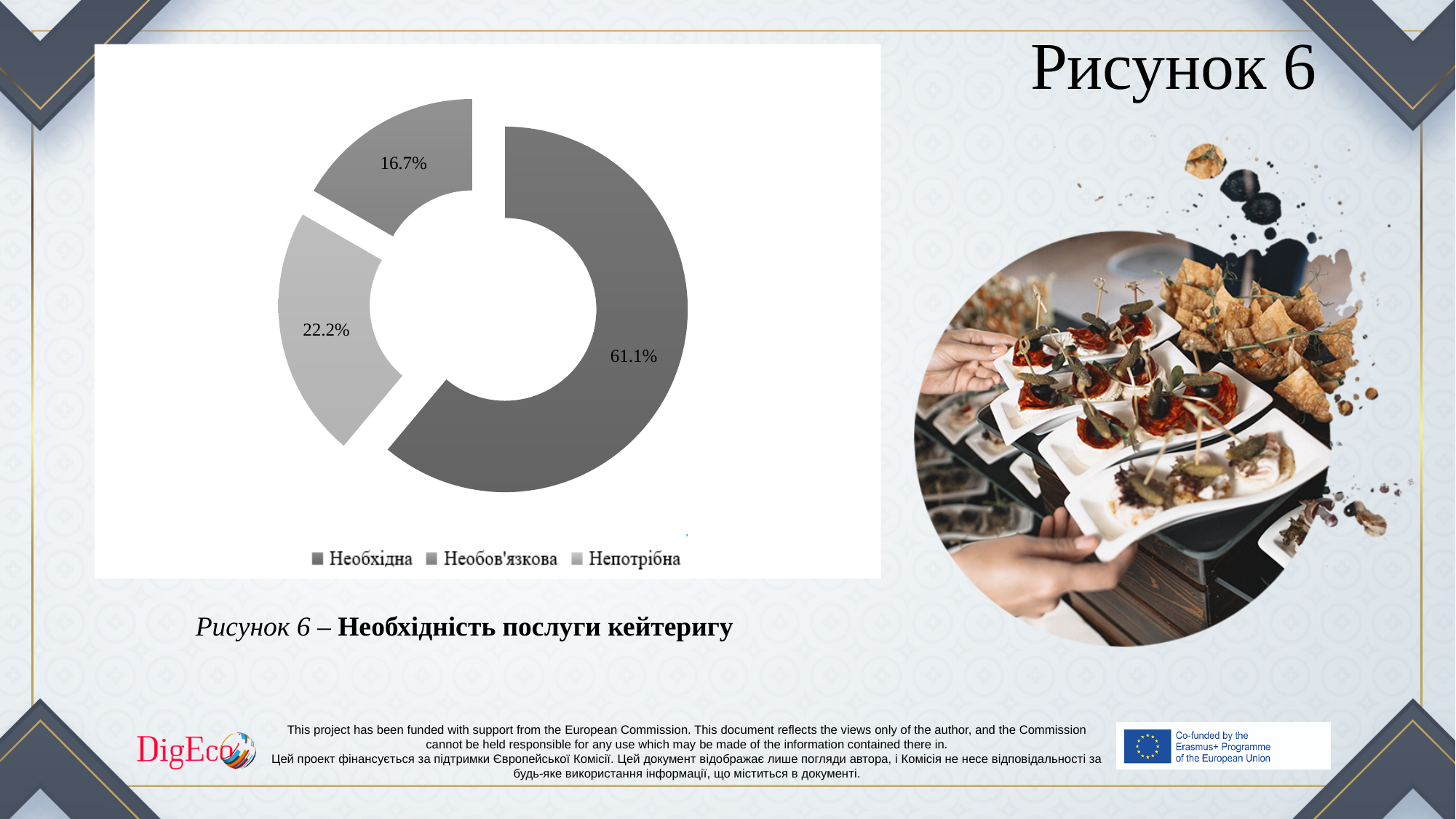
Which category has the largest slice in the chart? Необхідна What is the difference between the 'Необхідна' and 'Непотрібна' shares? 38.9% What share of the chart does the 'Необов'язкова' slice represent? 16.7% What kind of chart is shown on the slide? Doughnut (pie) chart What is the caption of the figure below the chart? Рисунок 6 – Необхідність послуги кейтеригу What share of the chart does the 'Необхідна' slice represent? 61.1% Which category has the smallest slice in the chart? Необов'язкова How many categories does the chart show? 3 What share of the chart does the 'Непотрібна' slice represent? 22.2% Which is larger, the 'Непотрібна' slice or the 'Необов'язкова' slice? Непотрібна Which legend entry is shown with the darkest colour? Необхідна What is the difference between the 'Непотрібна' and 'Необов'язкова' shares? 5.5%